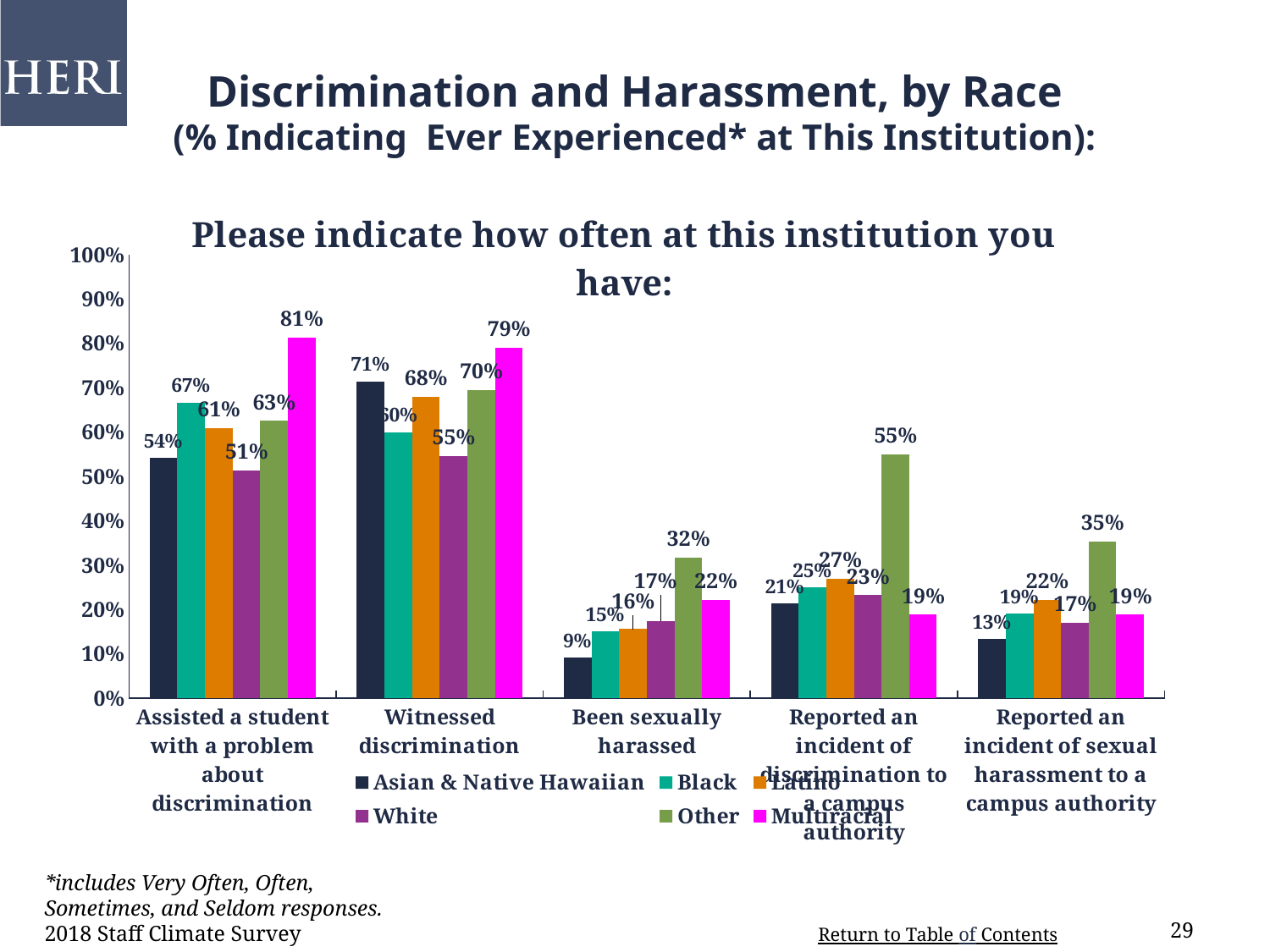
How many categories are shown on the x axis of the chart? 5 What type of chart is shown on the slide? Bar chart How many series does the legend list? 6 Which racial group has the lowest value for 'Been sexually harassed'? Asian & Native Hawaiian Which racial group has the highest value for 'Witnessed discrimination'? Multiracial What percentage of Multiracial staff indicated they had assisted a student with a problem about discrimination? 81% Is the value for Other staff who have been sexually harassed greater or less than 30%? greater For 'Assisted a student with a problem about discrimination', which is larger: the Black value or the Latino value? Black What percentage of Asian & Native Hawaiian staff indicated they had witnessed discrimination? 71% What percentage of Other staff indicated they had reported an incident of discrimination to a campus authority? 55% Which colour represents the Multiracial series in the chart? Magenta What is the difference between the Other and White values for 'Reported an incident of sexual harassment to a campus authority'? 18%